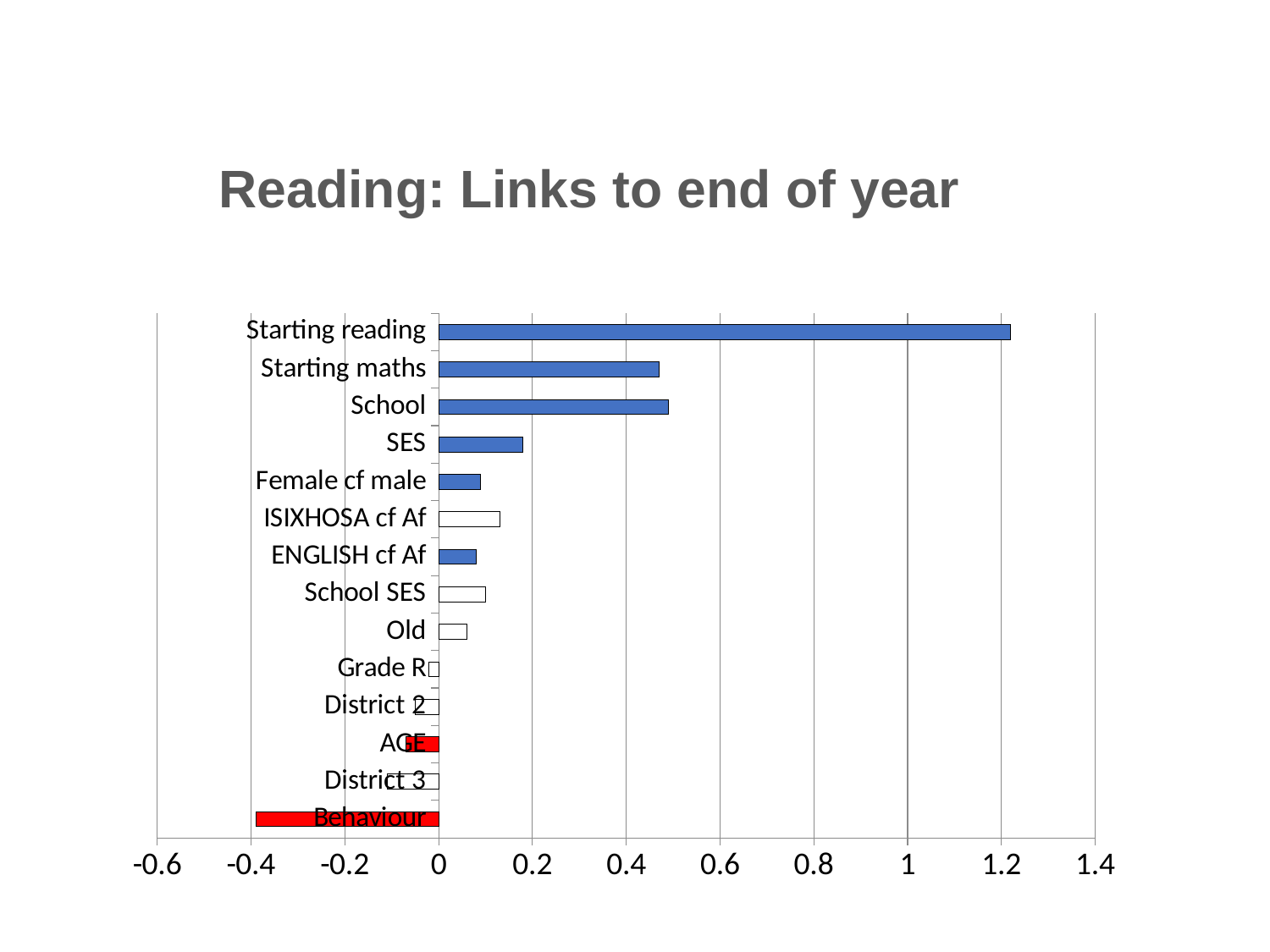
Is the value for School greater or less than 0.6? less Is the value for Behaviour greater or less than -0.2? less What type of chart is shown on the slide? bar chart How many categories are plotted in the chart? 14 Is the value for Starting maths greater or less than 0.4? greater Which is larger, the value for Starting reading or the value for School? Starting reading Which is larger, the value for SES or the value for Female cf male? SES Which category has the lowest value in the chart? Behaviour What colour is the bar for Behaviour? red What is the title of the chart on the slide? Reading: Links to end of year Which category has the highest value in the chart? Starting reading